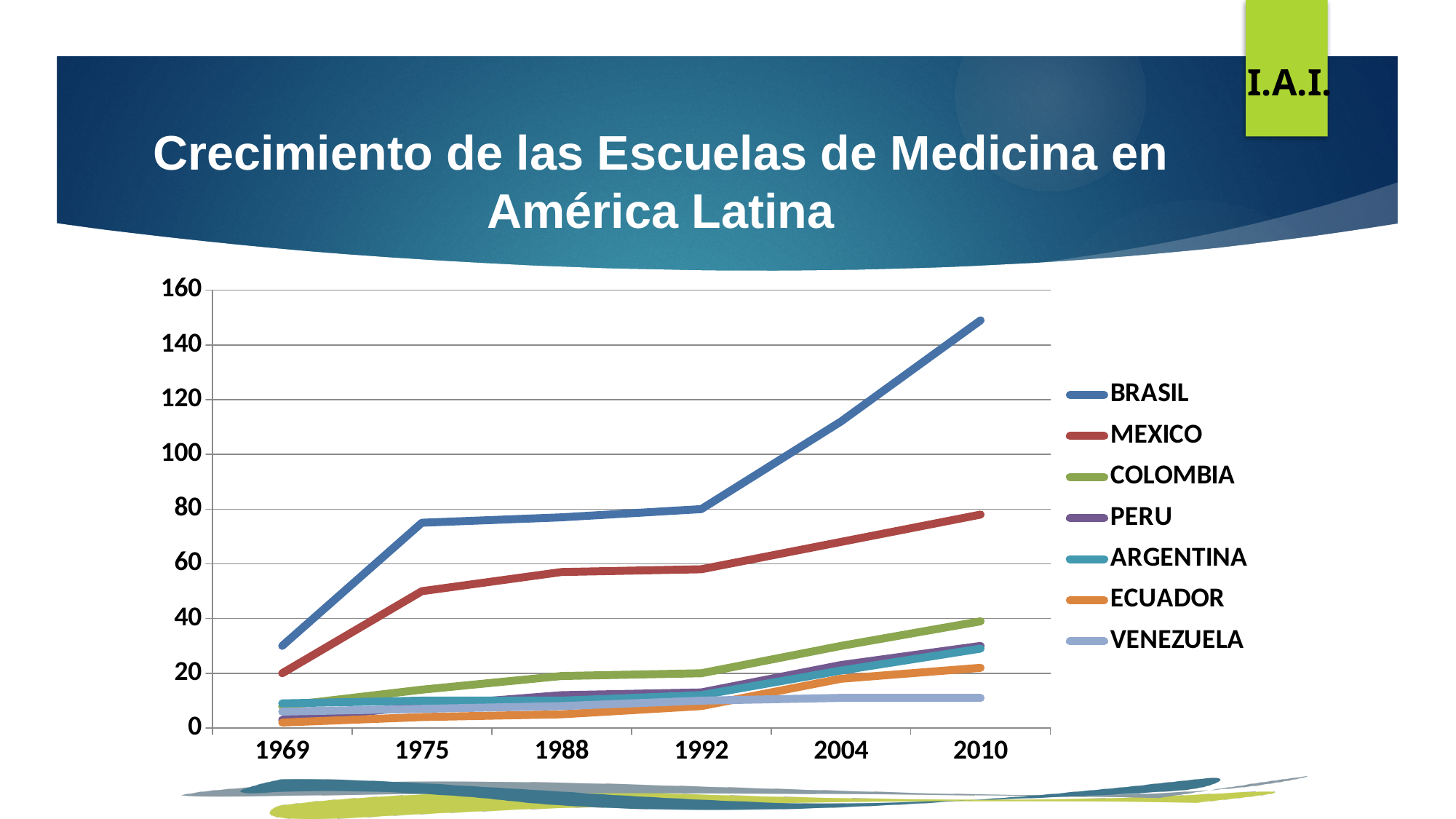
What is the title of the chart? Crecimiento de las Escuelas de Medicina en América Latina How many series does the legend list? 7 Which is larger in 2010, the value for MEXICO or the value for COLOMBIA? MEXICO Which country has the lowest value in 2010? VENEZUELA Is the value for BRASIL in 2010 greater or less than 140? greater What kind of chart is shown on the slide? line chart Does the value for BRASIL rise or fall from 1969 to 2010? rise What is the value for MEXICO in 1969? 20 How many years are shown along the x axis? 6 Which country has the highest value in 2010? BRASIL